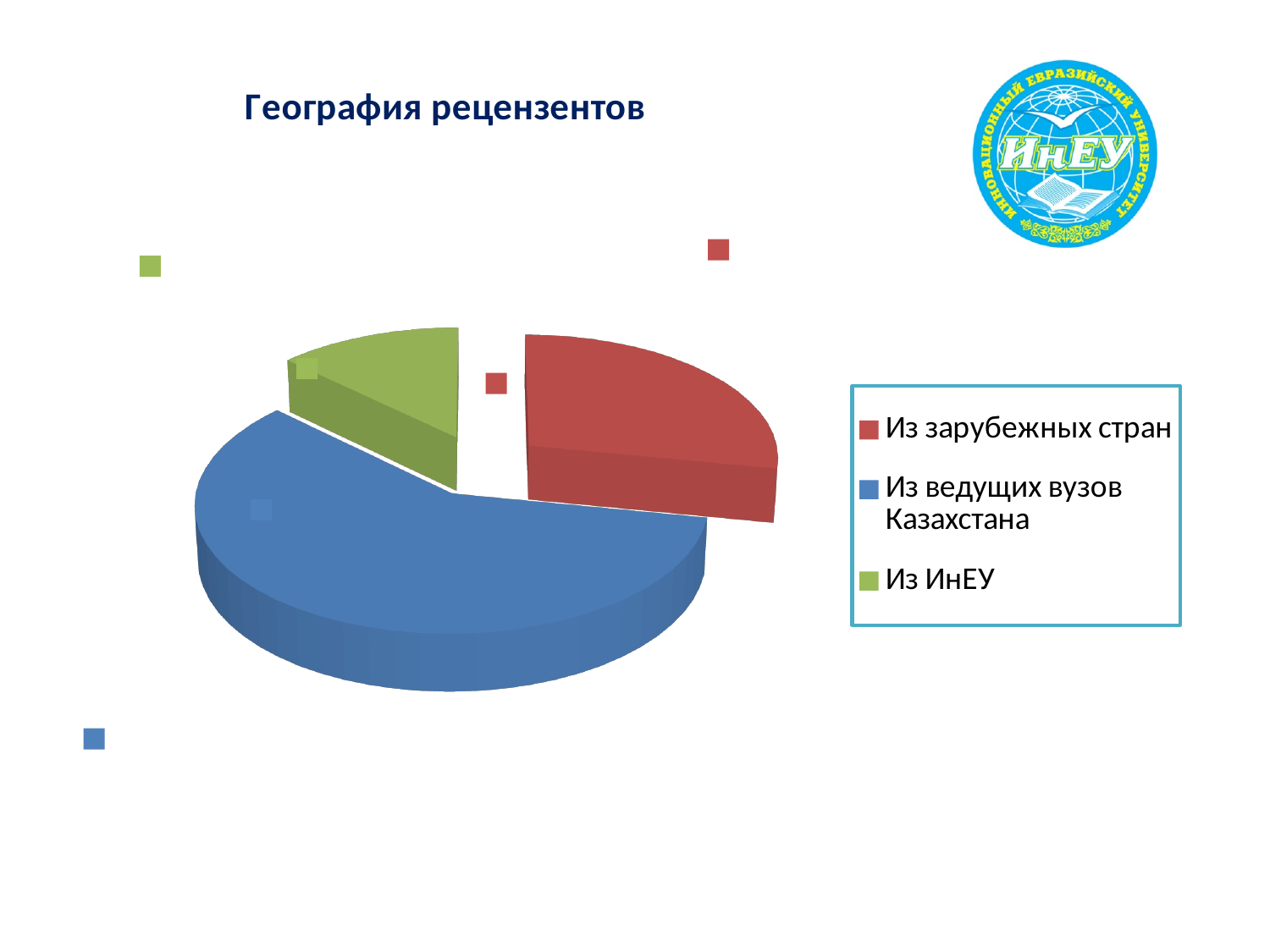
How many slices does the pie chart have? 3 Which category has the largest slice of the pie? Из ведущих вузов Казахстана Which slice is larger: Из зарубежных стран or Из ИнЕУ? Из зарубежных стран What kind of chart is shown on the slide? Pie chart What is the title of the chart? География рецензентов Which category has the smallest slice of the pie? Из ИнЕУ Which slice is larger: Из ведущих вузов Казахстана or Из зарубежных стран? Из ведущих вузов Казахстана What colour is the slice for Из зарубежных стран? Red How many entries does the legend list? 3